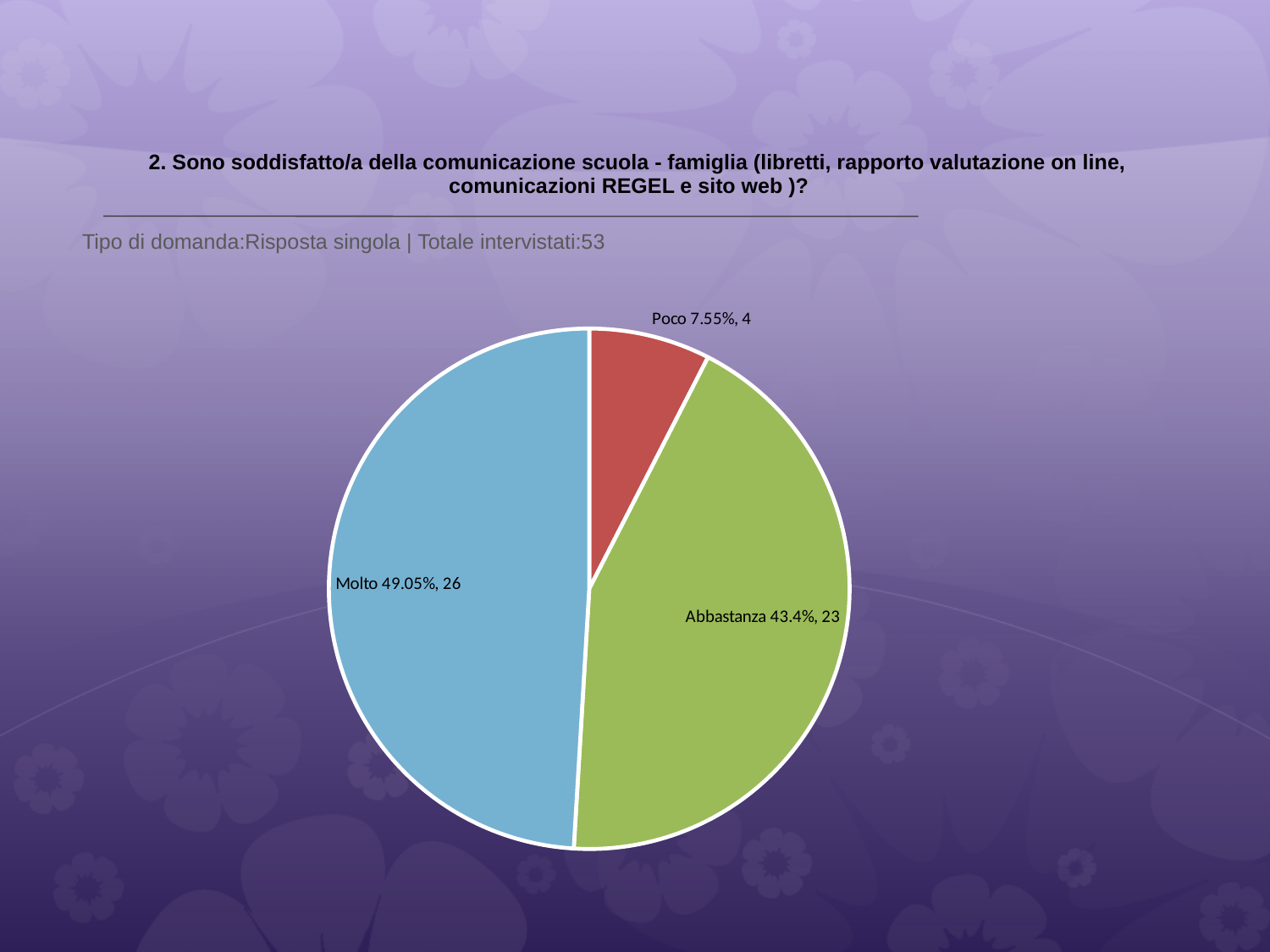
What percentage share does the 'Molto' slice have? 49.05% What is the difference in respondent count between 'Molto' and 'Abbastanza'? 3 Which response has the largest slice of the pie? Molto How many respondents answered 'Abbastanza'? 23 How many respondents answered 'Molto'? 26 What colour is the 'Poco' slice? red How many respondents answered 'Poco'? 4 What percentage share does the 'Abbastanza' slice have? 43.4% Which response has the smallest slice of the pie? Poco What percentage share does the 'Poco' slice have? 7.55% How many slices does the pie chart have? 3 What kind of chart is shown on the slide? pie chart